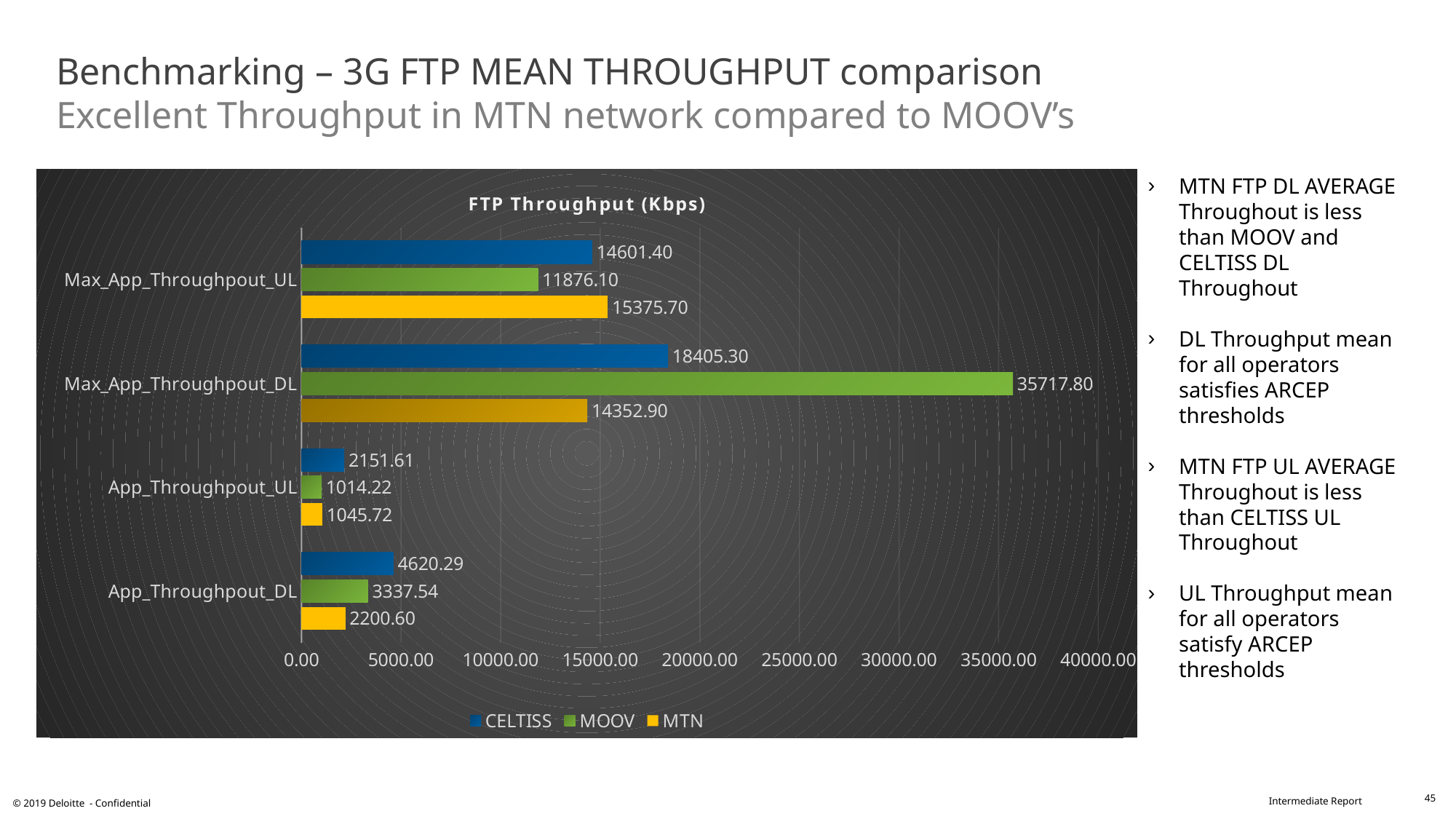
How many categories are shown on the chart? 4 What type of chart is shown on the slide? Bar chart What is the difference between the CELTISS and MTN values for App_Throughpout_DL? 2419.69 Which operator has the highest value for Max_App_Throughpout_DL? MOOV What is the CELTISS value for App_Throughpout_DL? 4620.29 Which is larger for Max_App_Throughpout_UL: the CELTISS value or the MOOV value? CELTISS Which operator has the lowest value for App_Throughpout_DL? MTN Is the MOOV value for Max_App_Throughpout_DL greater or less than 30000.00? greater What is the MOOV value for App_Throughpout_UL? 1014.22 What is the MTN value for Max_App_Throughpout_UL? 15375.70 What is the MOOV value for Max_App_Throughpout_DL? 35717.80 How many series does the legend list? 3